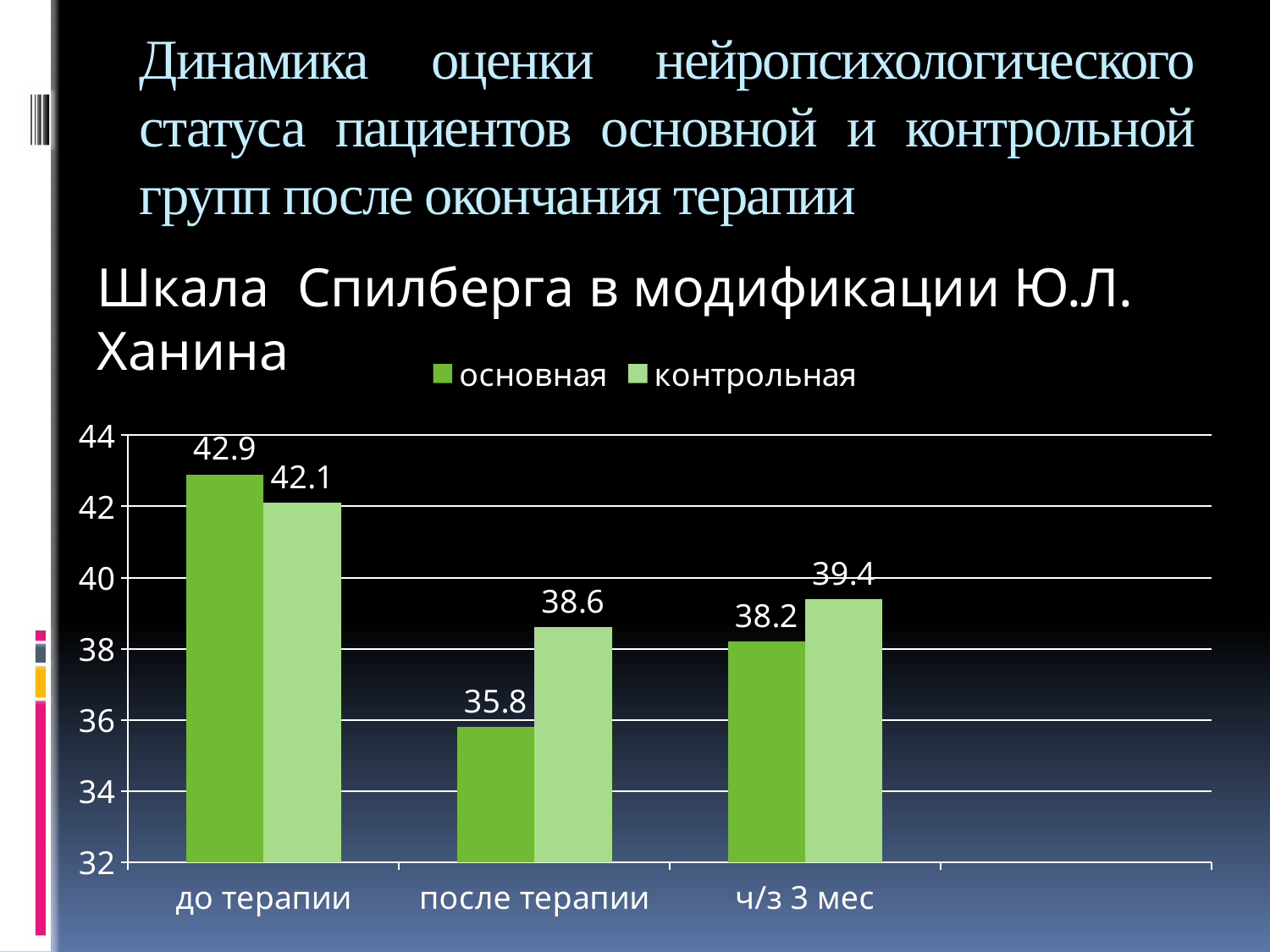
Which category has the highest value for контрольная? до терапии Which series is shown in the darker green colour? основная Which is larger at ч/з 3 мес, основная or контрольная? контрольная What kind of chart is shown on the slide? bar chart What is the difference between the основная values at до терапии and после терапии? 7.1 What is the difference between основная and контрольная at после терапии? 2.8 Which category has the lowest value for основная? после терапии How many series does the legend list? 2 What is the value for контрольная at после терапии? 38.6 What is the value for основная at ч/з 3 мес? 38.2 How many categories are shown on the x axis? 3 What is the value for основная at до терапии? 42.9